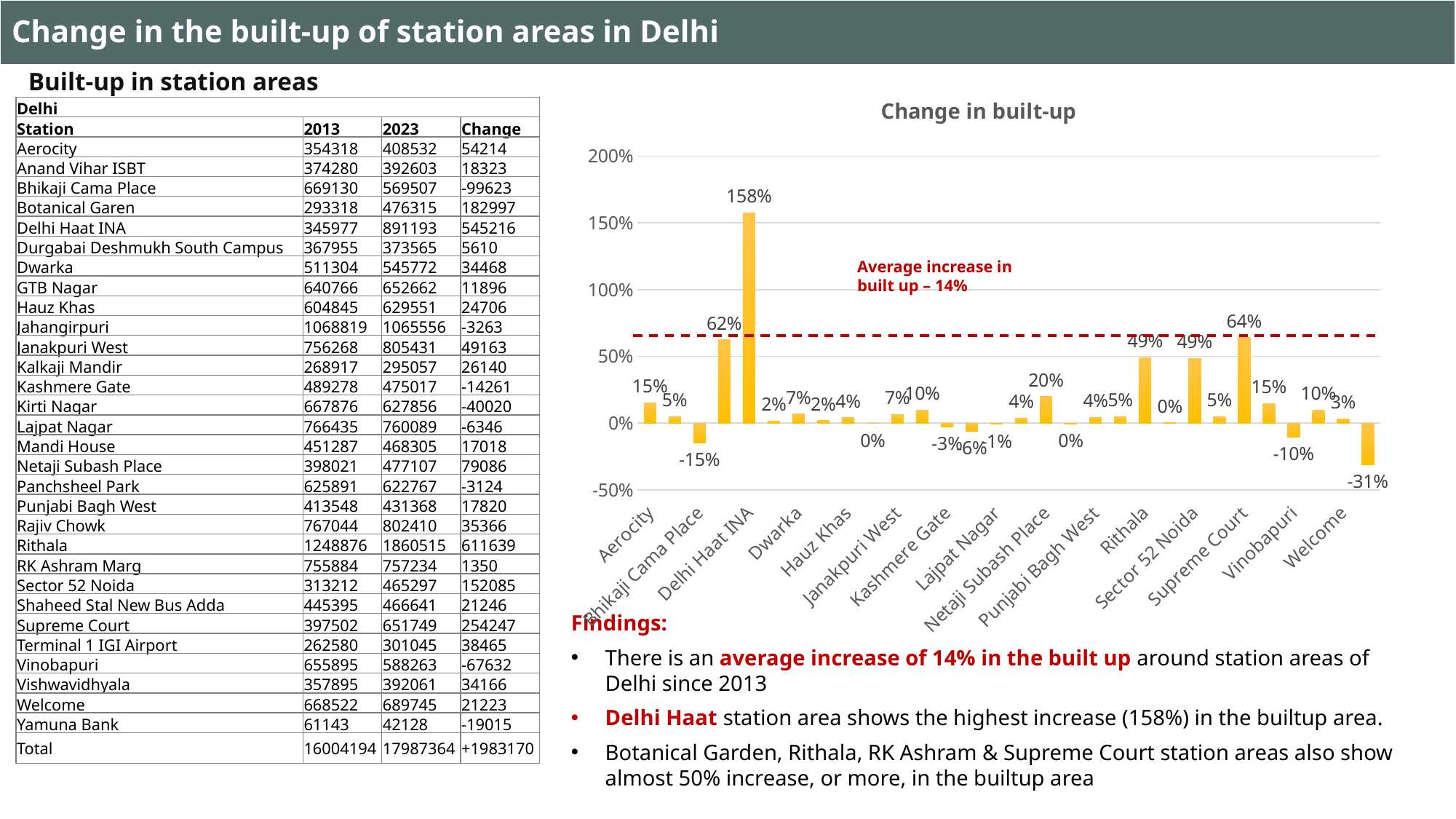
In the 'Change in built-up' chart, what is the value for Bhikaji Cama Place? -15% In the 'Change in built-up' chart, what is the value for Delhi Haat INA? 158% In the 'Change in built-up' chart, what is the value for Supreme Court? 64% In the 'Change in built-up' chart, which station has the highest value? Delhi Haat INA In the 'Change in built-up' chart, is the value for Delhi Haat INA greater or less than 150%? greater In the 'Change in built-up' chart, which is larger, the value for Supreme Court or the value for Aerocity? Supreme Court In the 'Change in built-up' chart, what is the difference between the values for Supreme Court and Rithala? 15% What average increase in built-up does the dashed line on the 'Change in built-up' chart mark? 14% In the 'Change in built-up' chart, what is the value for Netaji Subash Place? 20% In the 'Change in built-up' chart, is the value for Vinobapuri greater or less than 0%? less In the 'Change in built-up' chart, what is the value for Rithala? 49% What kind of chart is 'Change in built-up'? bar chart